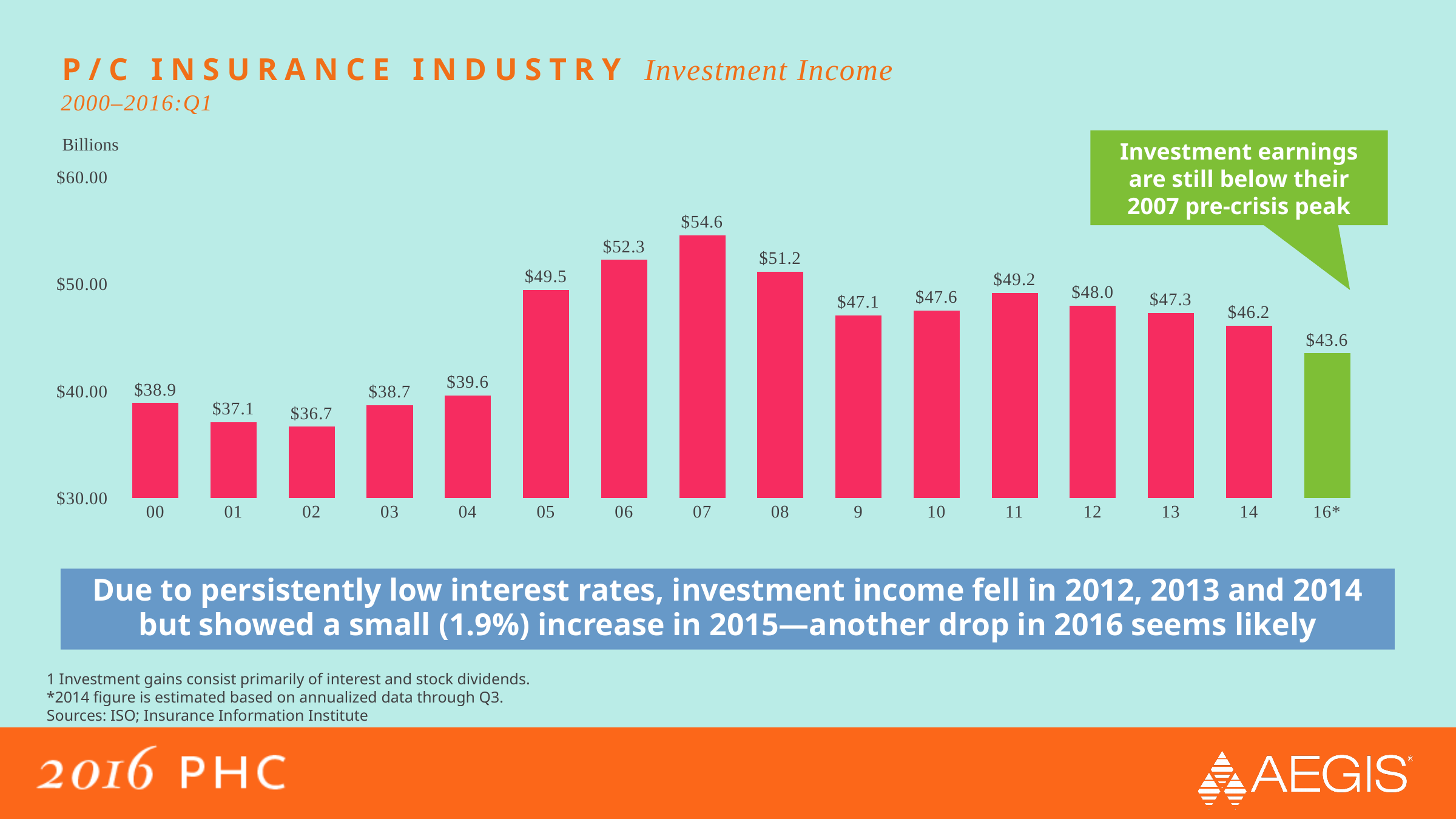
Is the value for 14 greater or less than $50.00? less What kind of chart is shown on the slide? bar chart What is the investment income value shown for 07? $54.6 Which bar on the chart is coloured green rather than pink? 16* What is the difference between the values for 07 and 16*? $11.0 What is the investment income value shown for 02? $36.7 What is the investment income value shown for 16*? $43.6 Which year has the highest investment income on the chart? 07 Which year has the lowest investment income on the chart? 02 What is the difference between the values for 06 and 05? $2.8 Which is larger, the value for 11 or the value for 12? 11 How many bars are plotted on the chart? 16